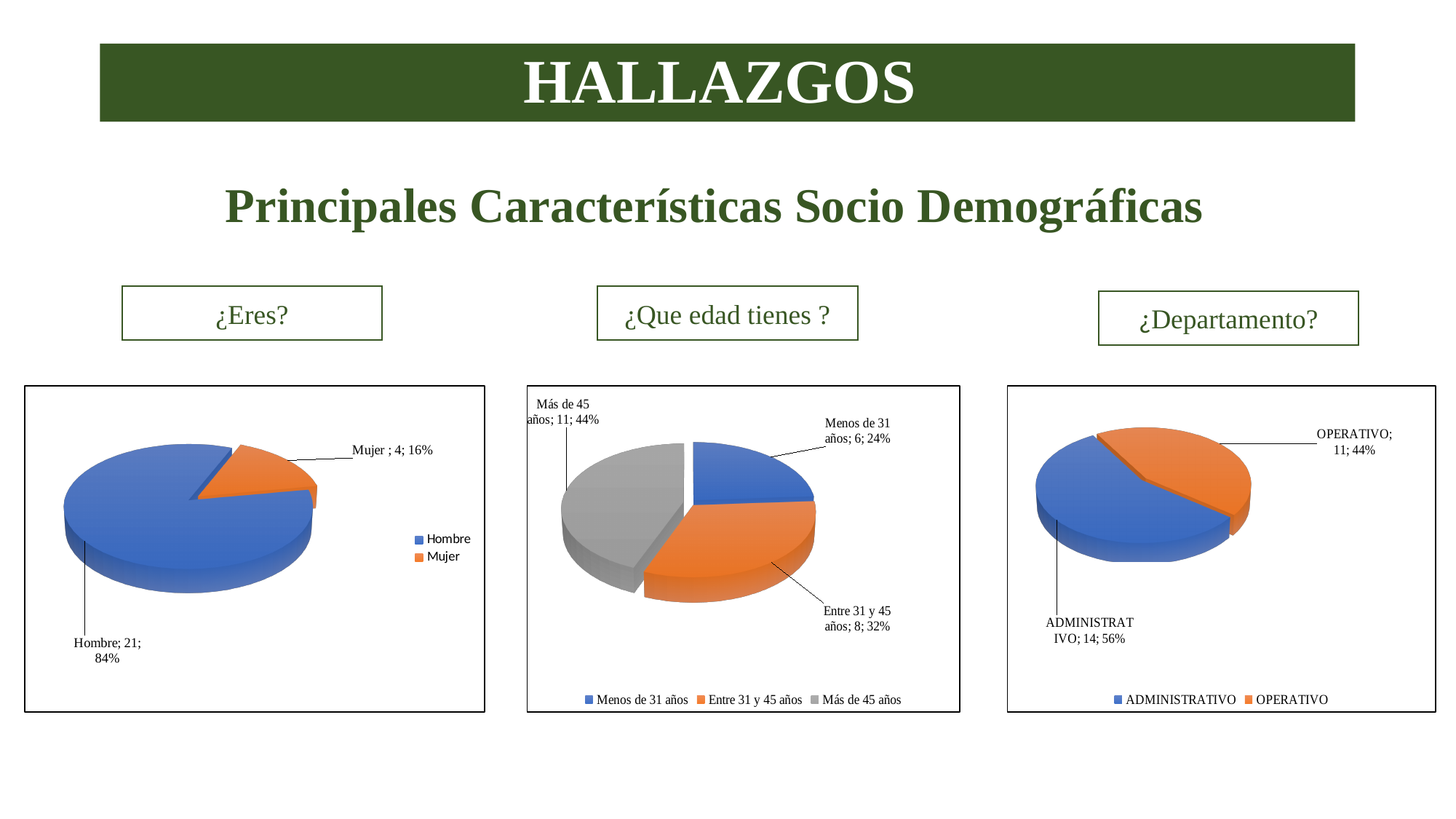
In the '¿Que edad tienes ?' chart, what share of the pie is 'Menos de 31 años'? 24% In the '¿Eres?' chart, what kind of chart is shown? pie chart In the '¿Eres?' chart, what share of the pie is Mujer? 16% In the '¿Departamento?' chart, how many respondents are ADMINISTRATIVO? 14 In the '¿Que edad tienes ?' chart, how many categories does the legend list? 3 In the '¿Departamento?' chart, what colour is the OPERATIVO slice? orange In the '¿Departamento?' chart, which is larger, ADMINISTRATIVO or OPERATIVO? ADMINISTRATIVO In the '¿Que edad tienes ?' chart, which age group has the smallest slice? Menos de 31 años In the '¿Que edad tienes ?' chart, how many respondents are 'Entre 31 y 45 años'? 8 In the '¿Eres?' chart, how many respondents are Hombre? 21 In the '¿Eres?' chart, what is the difference between the Hombre and Mujer counts? 17 In the '¿Que edad tienes ?' chart, which age group has the largest slice? Más de 45 años